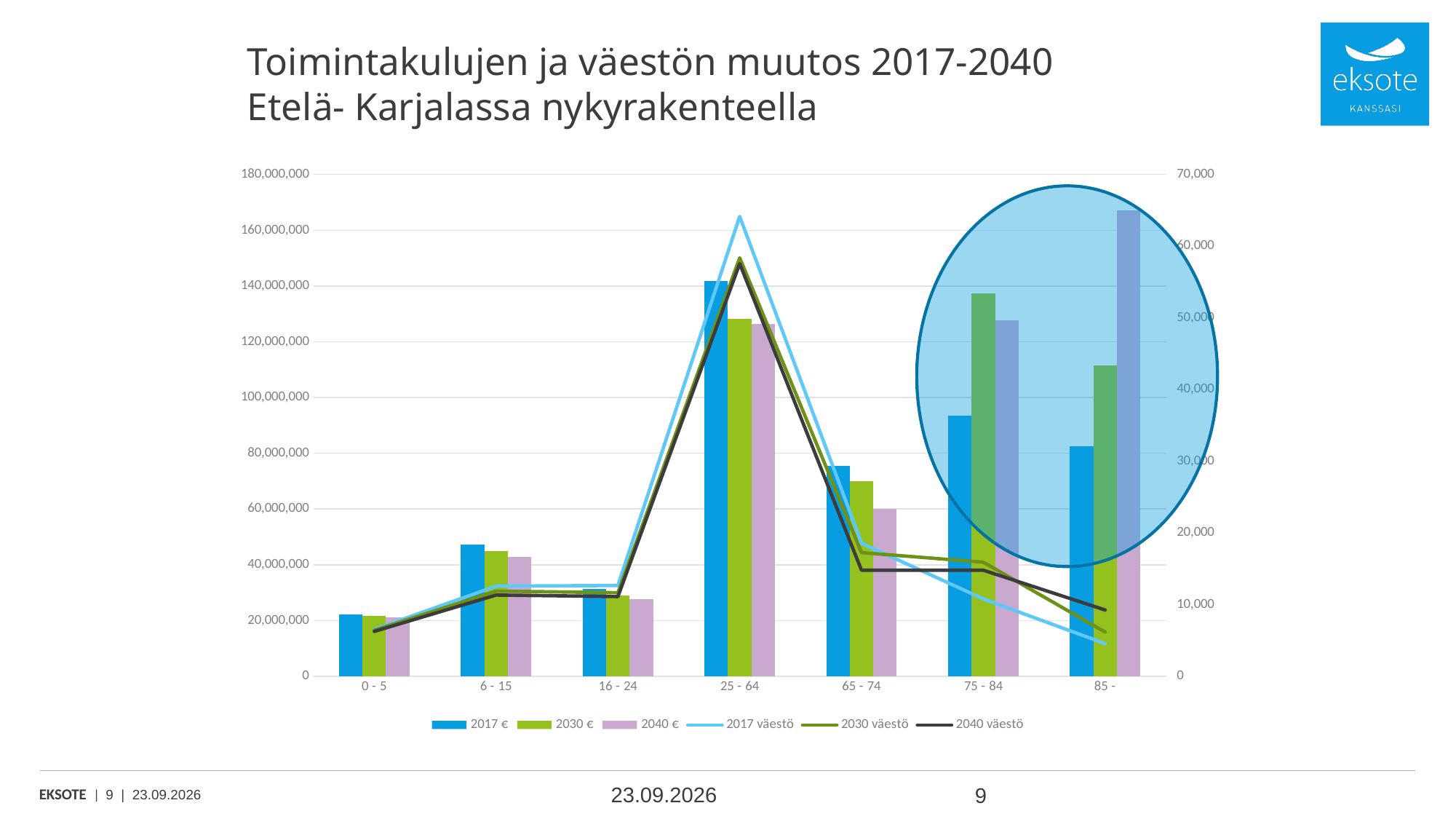
Does the 2017 väestö line rise or fall from the 65 - 74 age group to the 85 - age group? fall What kind of chart is shown on the slide? A combined bar and line chart Which age group has the highest 2017 € bar? 25 - 64 Is the 2040 € value for the 85 - age group greater or less than 160,000,000? greater Is the 2030 € value for the 75 - 84 age group greater or less than 120,000,000? greater Which age group has the highest 2040 € bar? 85 - How many age-group categories are shown on the x axis of the chart? 7 How many series does the chart legend list? 6 For the 85 - age group, which is larger: the 2017 € bar or the 2040 € bar? 2040 € Is the 2017 € value for the 65 - 74 age group greater or less than 80,000,000? less For the 25 - 64 age group, which is larger: the 2017 € bar or the 2040 € bar? 2017 € Which age group has the lowest 2017 € bar? 0 - 5